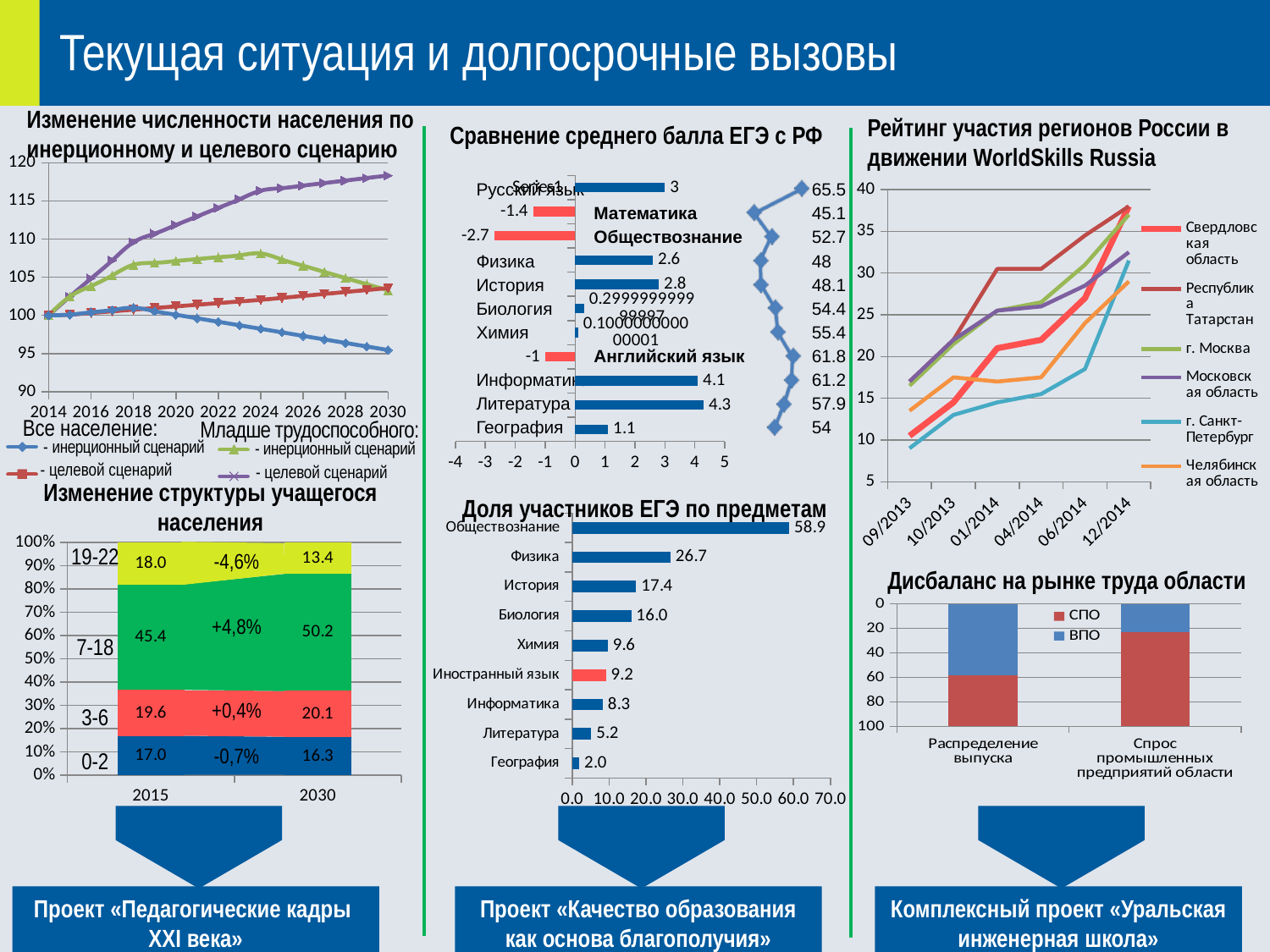
How many subjects are shown in the chart 'Доля участников ЕГЭ по предметам'? 9 In the chart 'Изменение структуры учащегося населения', what is the value for the 7-18 group in 2030? 50.2 In the chart 'Доля участников ЕГЭ по предметам', what is the value for Физика? 26.7 What kind of chart is 'Рейтинг участия регионов России в движении WorldSkills Russia'? Line chart In the chart 'Сравнение среднего балла ЕГЭ с РФ', which is larger, the bar value for Физика or for История? История In the chart 'Доля участников ЕГЭ по предметам', which subject has the highest value? Обществознание In the chart 'Изменение структуры учащегося населения', what is the value for the 0-2 group in 2015? 17.0 In the chart 'Доля участников ЕГЭ по предметам', what is the difference between the values for История and Биология? 1.4 In the chart 'Доля участников ЕГЭ по предметам', which subject has the lowest value? География In the chart 'Сравнение среднего балла ЕГЭ с РФ', what is the bar value for Литература? 4.3 How many series does the legend list in the chart 'Рейтинг участия регионов России в движении WorldSkills Russia'? 6 In the chart 'Сравнение среднего балла ЕГЭ с РФ', what is the bar value for Обществознание? -2.7